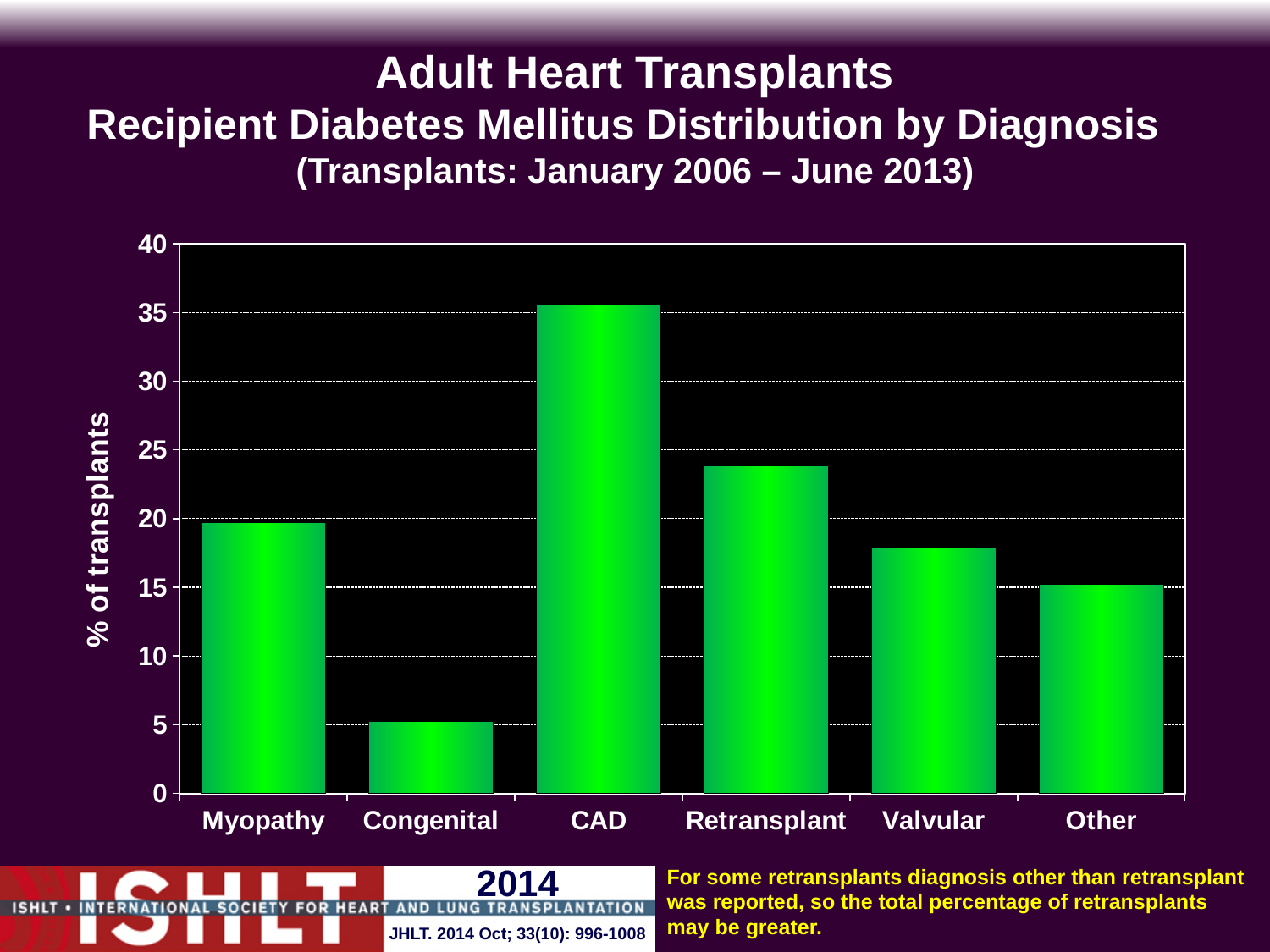
Which has a higher percentage of transplants, Retransplant or Valvular? Retransplant What type of chart is shown on the slide? bar chart Which has a higher percentage of transplants, Myopathy or Other? Myopathy How many diagnosis categories are shown on the x axis? 6 What is the label of the y axis? % of transplants Which diagnosis category has the lowest percentage of transplants? Congenital Is the value for Congenital greater or less than 10? less Is the value for Retransplant greater or less than 25? less Which diagnosis category has the highest percentage of transplants? CAD Is the value for Myopathy greater or less than 15? greater